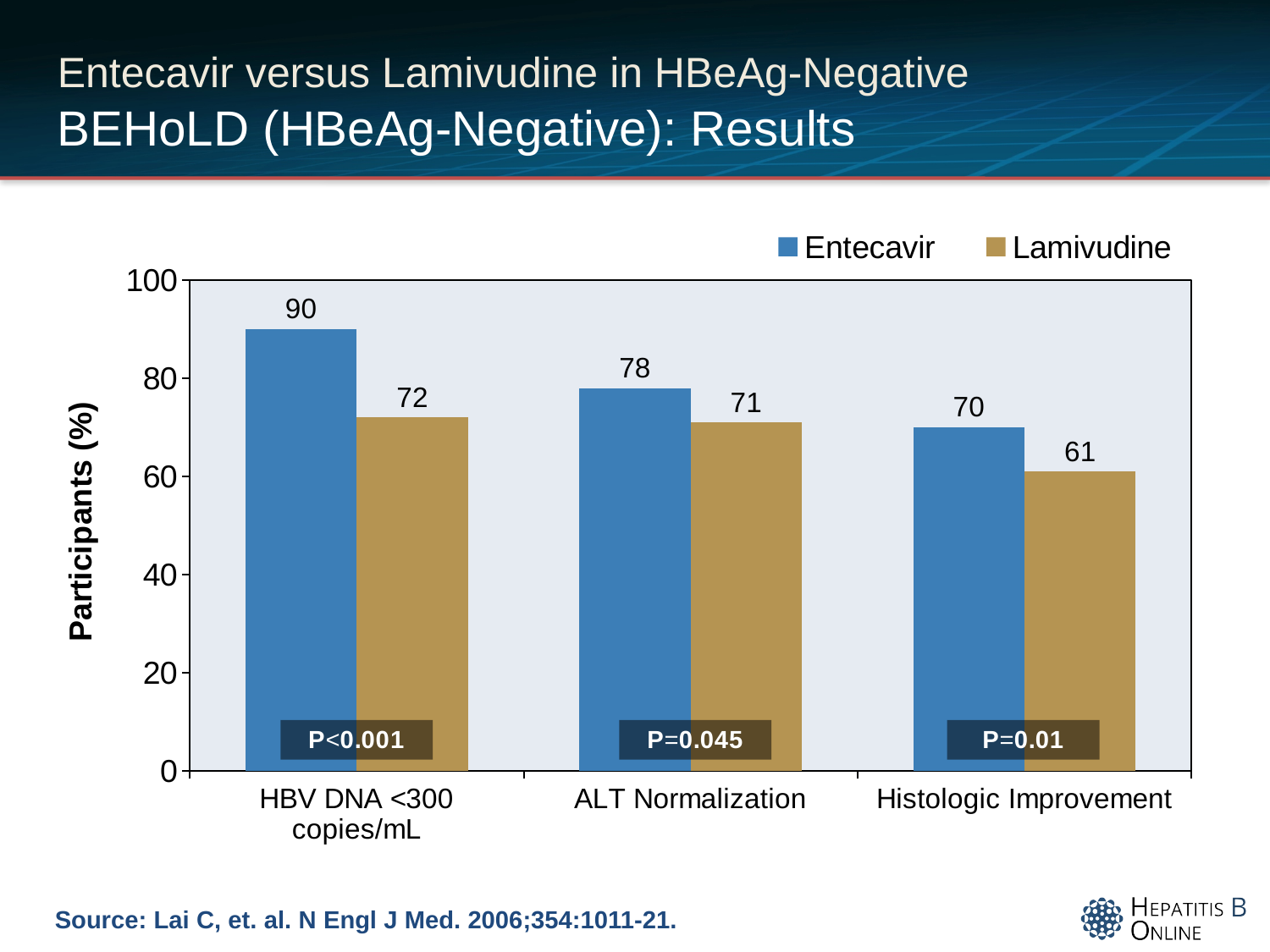
How many categories are shown on the x axis? 3 What is the value for Lamivudine in the Histologic Improvement category? 61 What is the difference between Entecavir and Lamivudine for Histologic Improvement? 9 Which category has the highest value for Entecavir? HBV DNA <300 copies/mL Which category has the lowest value for Lamivudine? Histologic Improvement Which is larger for ALT Normalization, Entecavir or Lamivudine? Entecavir What kind of chart is shown on the slide? Bar chart What is the difference between Entecavir and Lamivudine for HBV DNA <300 copies/mL? 18 What is the y-axis label of the chart? Participants (%) What percentage of Entecavir participants achieved HBV DNA <300 copies/mL? 90 What is the value for Lamivudine for ALT Normalization? 71 How many series does the legend list? 2